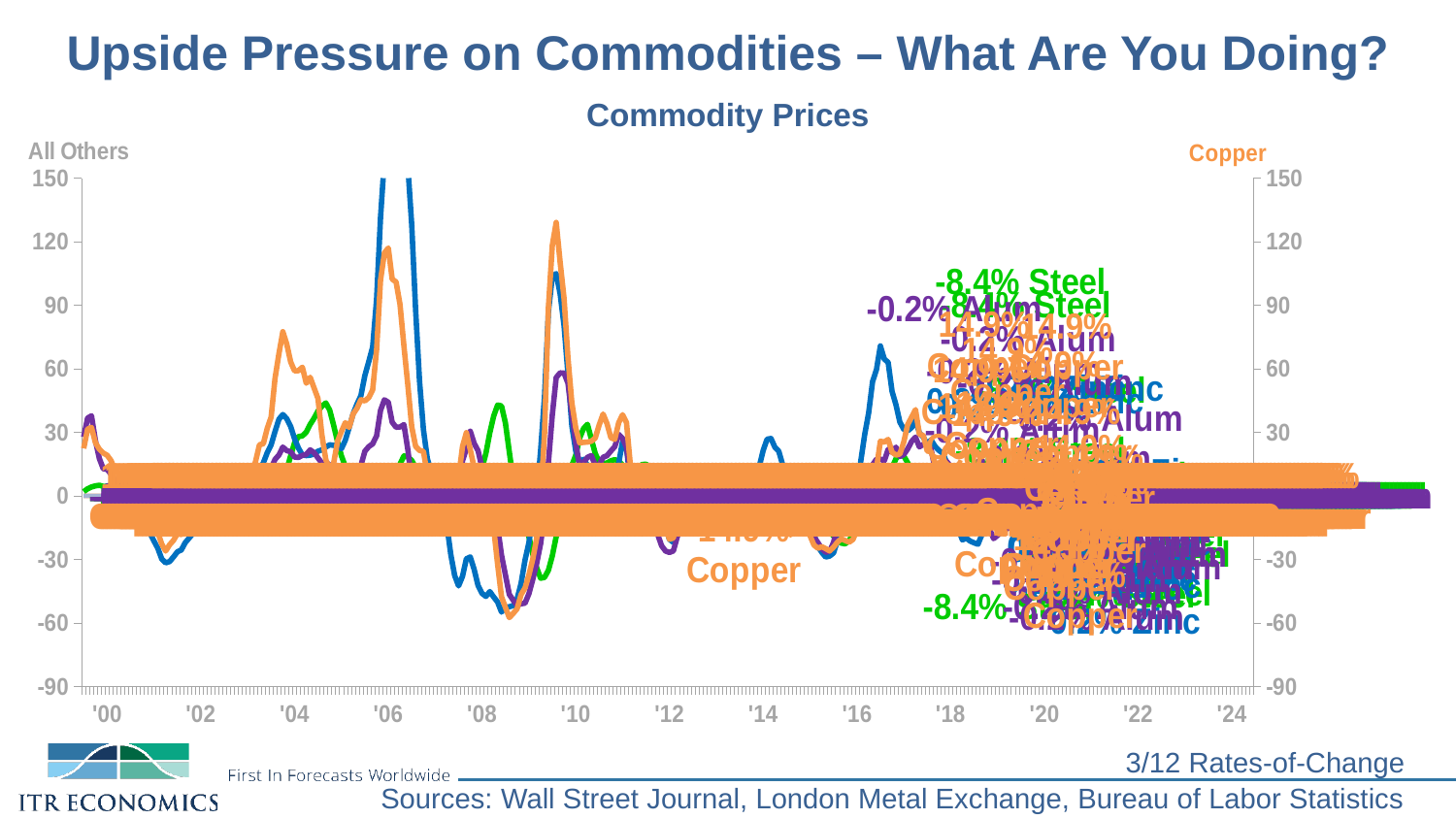
What is the first year label on the x axis of the chart? '00 Around '06, is the peak of the orange Copper line greater or less than 90? greater What type of measure does the note at the bottom right say the chart shows? 3/12 Rates-of-Change What kind of chart is shown on the slide? Line chart Around '08 to '09, is the trough of the orange Copper line greater or less than -30? less What is the lowest value shown on the right-hand axis of the chart? -90 Around '06, does the blue line rise above or stay below 120? rises above What is the last year label on the x axis of the chart? '24 What is the title of the chart? Commodity Prices What is the highest value shown on the left-hand axis of the chart? 150 Which commodity is plotted against the right-hand axis of the chart? Copper